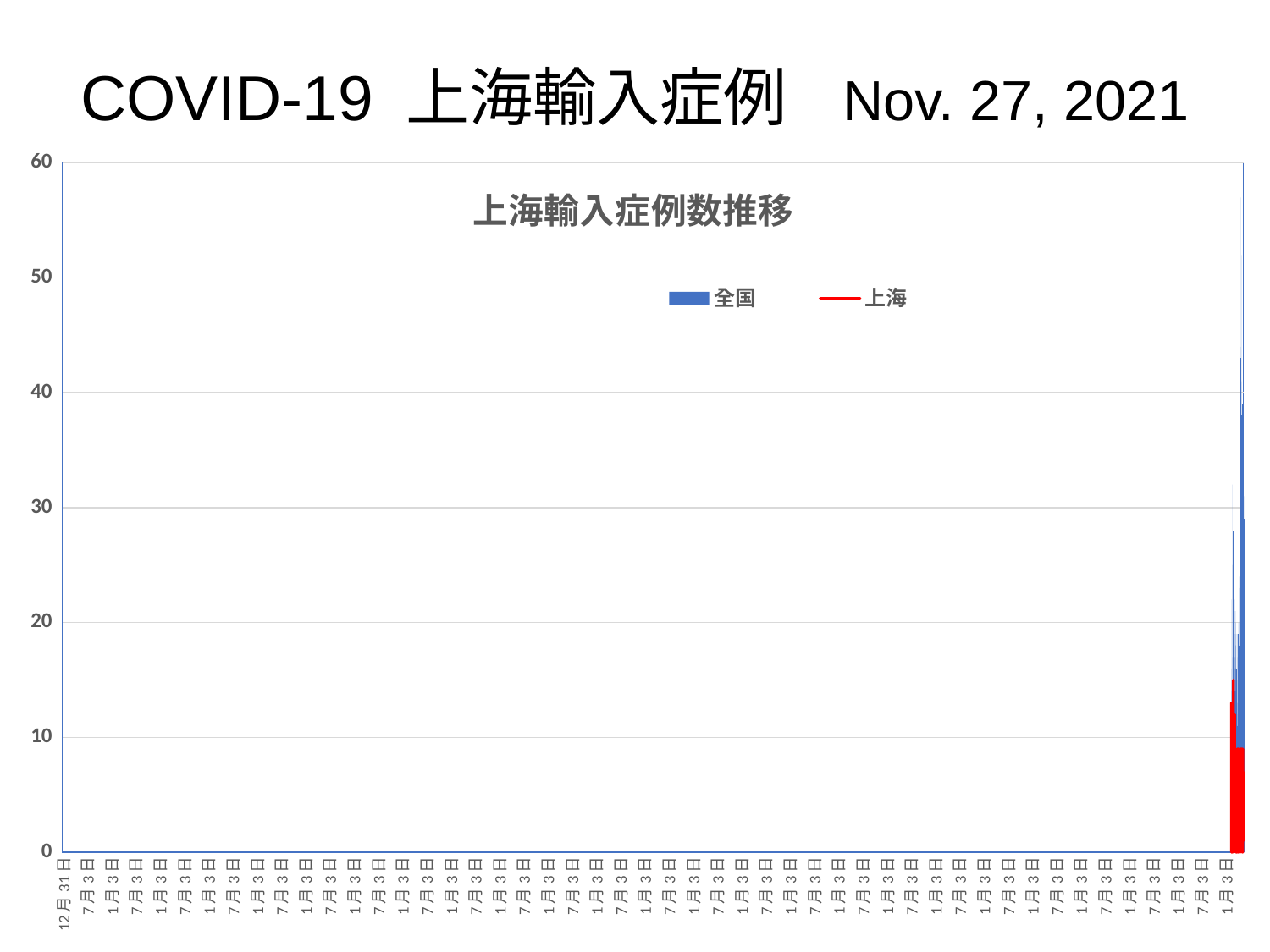
Is the peak value of the 上海 series greater or less than 20? less What is the highest value shown on the chart's vertical axis? 60 What is the title of the chart on the slide? 上海輸入症例数推移 How many series does the chart legend list? 2 What are the two series named in the chart legend? 全国 and 上海 Is the peak value of the 上海 series greater or less than 10? greater Which series reaches a higher peak on the chart, 全国 or 上海? 全国 Is the peak value of the 全国 series greater or less than 40? greater